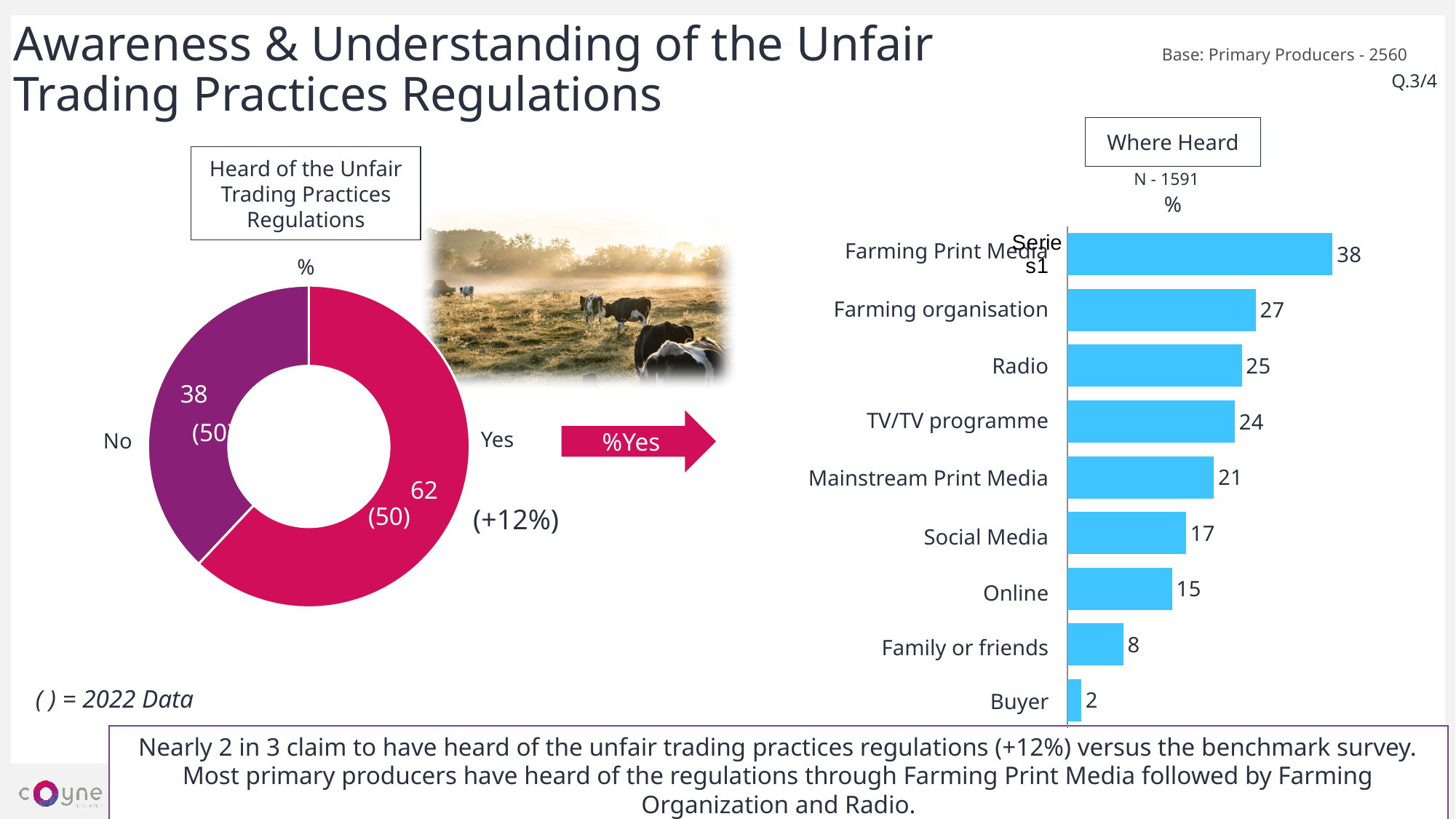
What kind of chart is the 'Where Heard' chart? Bar chart In the 'Where Heard' bar chart, which category has the lowest value? Buyer In the 'Heard of the Unfair Trading Practices Regulations' chart, what is the difference between Yes and No? 24 In the 'Where Heard' bar chart, what is the value for Farming Print Media? 38 In the 'Where Heard' bar chart, what is the value for Family or friends? 8 How many categories are shown in the 'Where Heard' bar chart? 9 In the 'Where Heard' bar chart, what is the difference between Farming organisation and Social Media? 10 In the 'Where Heard' bar chart, which category has the highest value? Farming Print Media In the 'Where Heard' bar chart, what is the value for Radio? 25 In the 'Heard of the Unfair Trading Practices Regulations' chart, what is the value for Yes? 62 What kind of chart is the 'Heard of the Unfair Trading Practices Regulations' chart? Donut chart In the 'Where Heard' bar chart, which is larger: TV/TV programme or Online? TV/TV programme